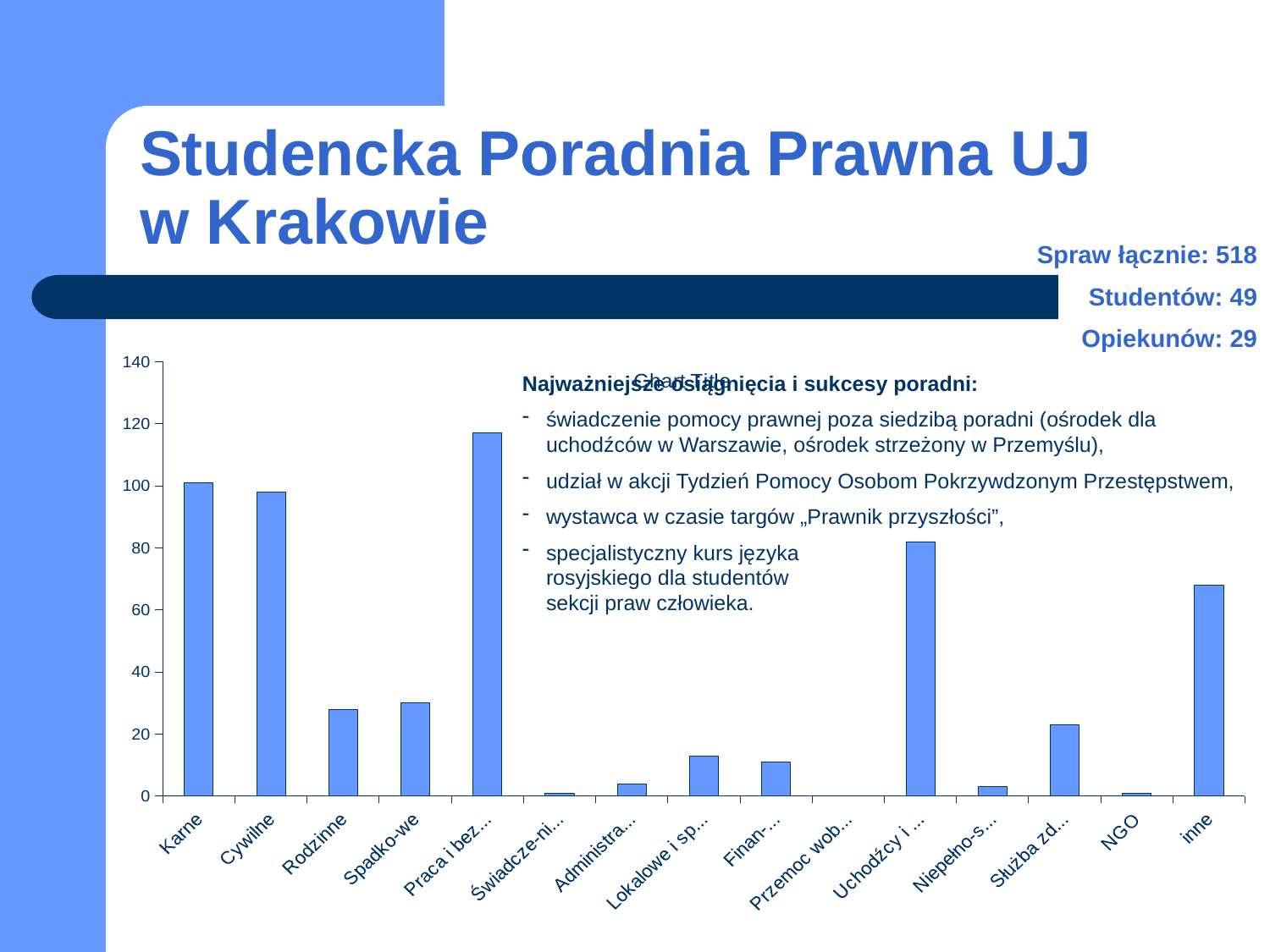
How many categories are shown on the x axis of the chart? 15 Which category has the highest bar in the chart? Praca i bez... Which is larger, the value for Praca i bez... or the value for Karne? Praca i bez... Is the value for Karne greater or less than 80? greater Is the value for Lokalowe i sp... greater or less than 20? less Which is larger, the value for Uchodźcy i ... or the value for inne? Uchodźcy i ... Is the value for Rodzinne greater or less than 20? greater What kind of chart is shown on the slide? bar chart